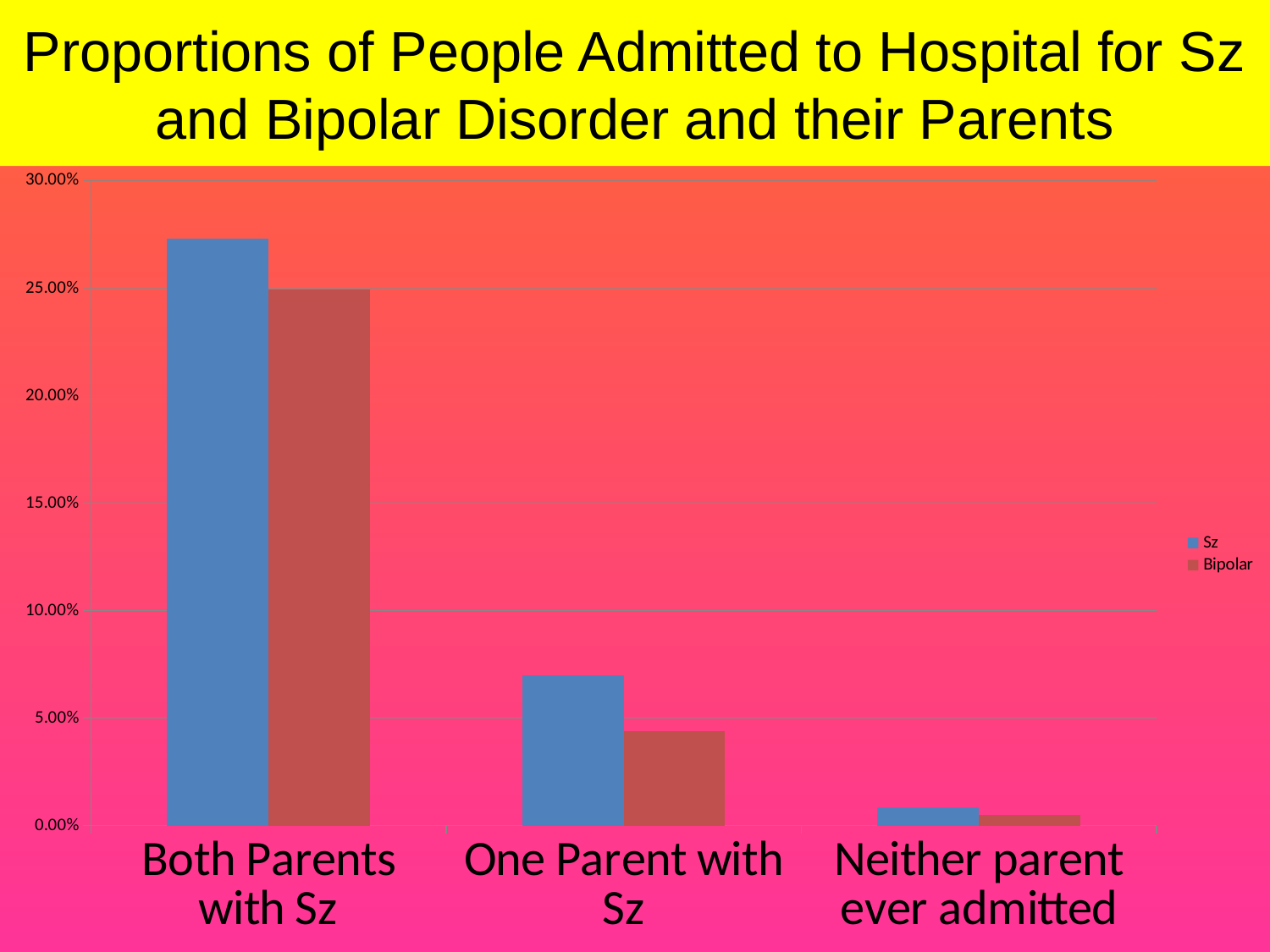
Is the Sz value for Both Parents with Sz greater or less than 25.00%? greater Is the Sz value for One Parent with Sz greater or less than 5.00%? greater Is the Bipolar value for Both Parents with Sz greater or less than 20.00%? greater What kind of chart is shown on the slide? bar chart How many categories are shown on the x axis? 3 Do the Sz values rise or fall moving from left to right across the categories? fall Which category has the highest value for the Sz series? Both Parents with Sz How many series does the legend list? 2 For Both Parents with Sz, which series has the larger value, Sz or Bipolar? Sz Which series is shown in blue? Sz Which category has the lowest value for the Bipolar series? Neither parent ever admitted